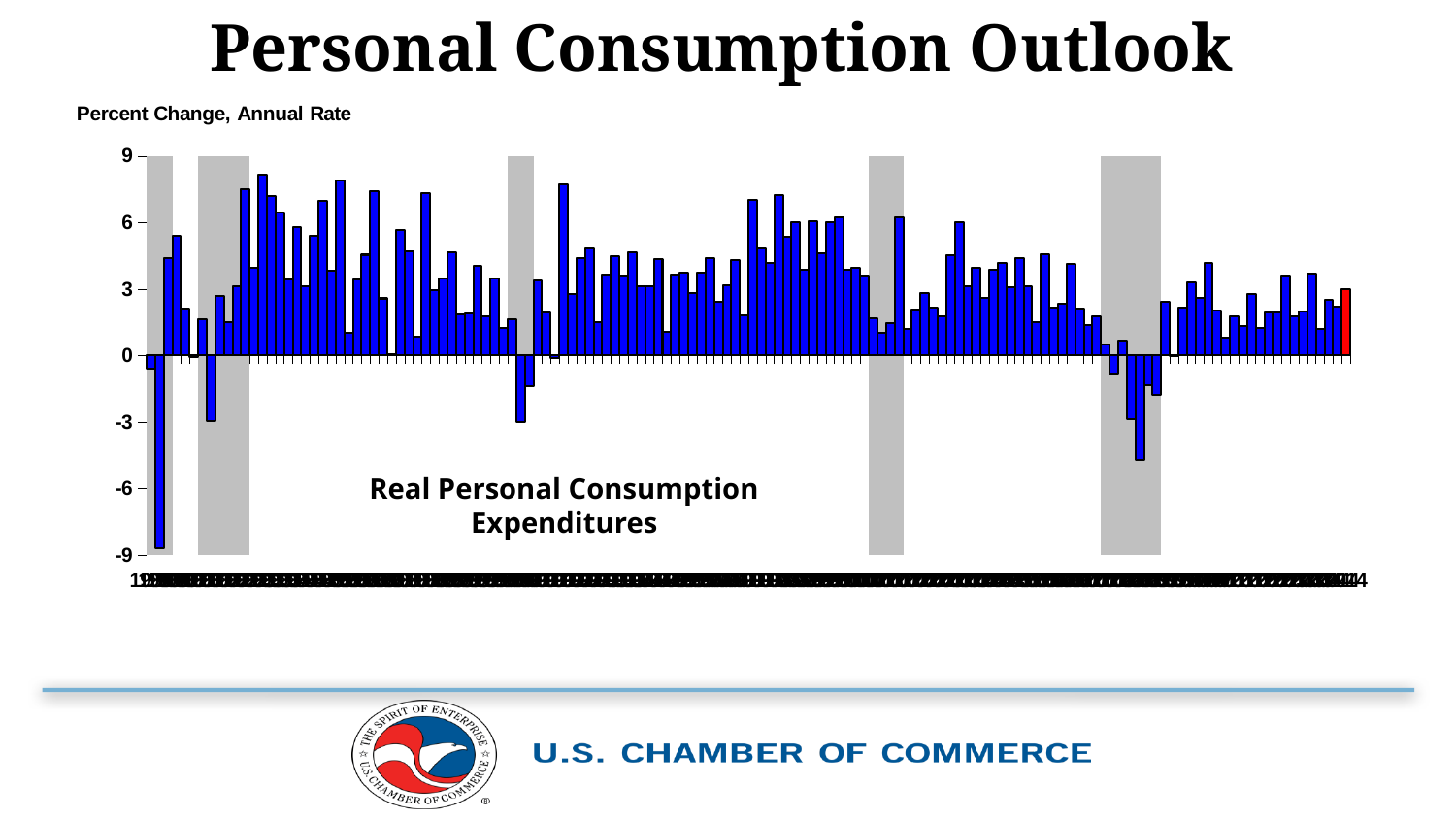
Is the value of the final (red) bar on the chart greater or less than 0? greater What kind of chart is shown on the slide? bar chart Is the lowest value on the chart greater or less than 0? less What is the title of the chart on the slide? Percent Change, Annual Rate What series label is printed inside the chart area? Real Personal Consumption Expenditures Is the highest value on the chart greater or less than 6? greater